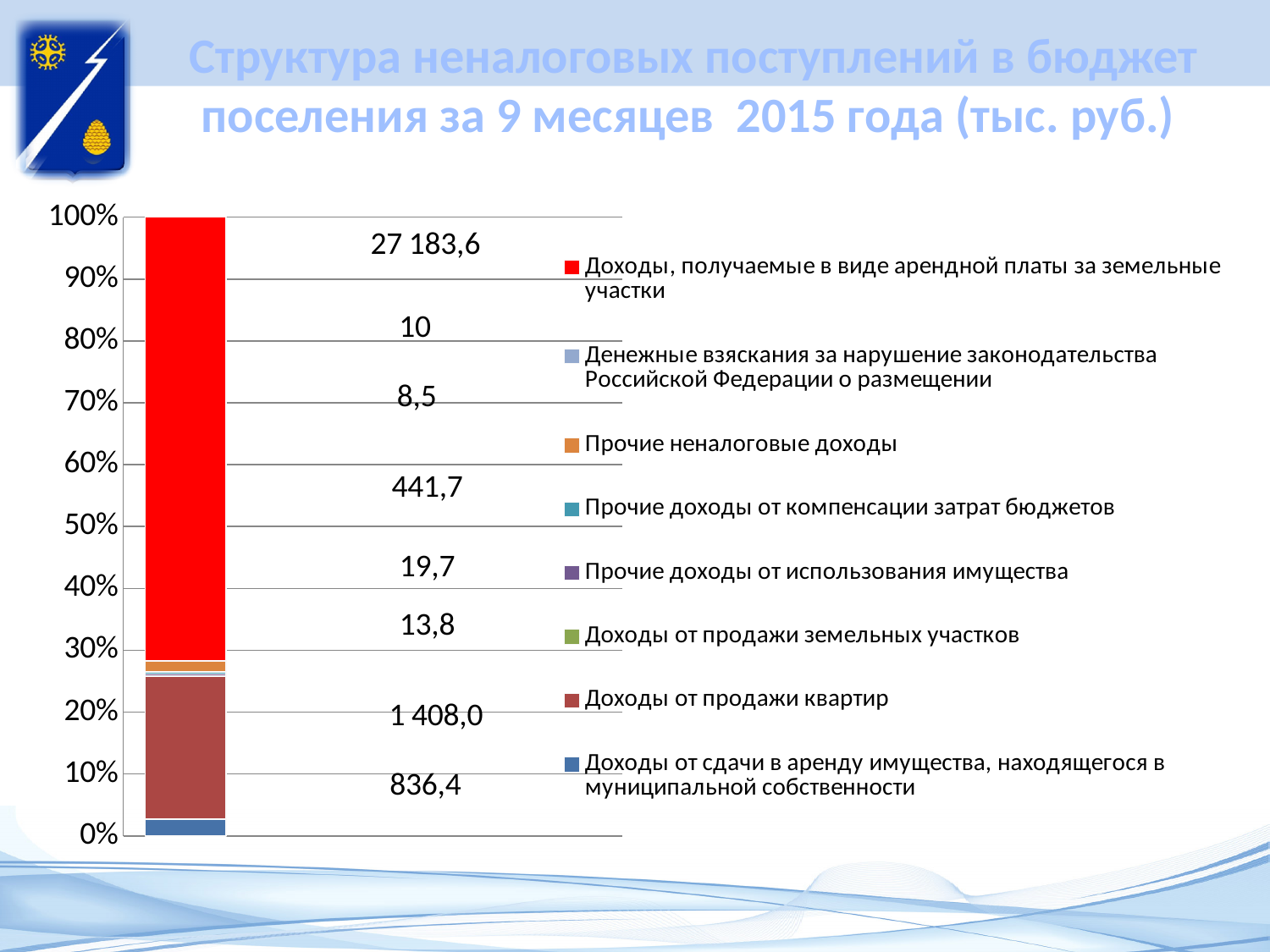
What is the difference between the values for 'Доходы от продажи квартир' and 'Доходы от сдачи в аренду имущества, находящегося в муниципальной собственности'? 571,6 How many series does the legend list? 8 Which category has the highest value? Доходы, получаемые в виде арендной платы за земельные участки What is the title of the slide? Структура неналоговых поступлений в бюджет поселения за 9 месяцев 2015 года (тыс. руб.) What value is shown for 'Прочие доходы от компенсации затрат бюджетов'? 441,7 Which is larger: the value for 'Прочие доходы от компенсации затрат бюджетов' or for 'Прочие доходы от использования имущества'? Прочие доходы от компенсации затрат бюджетов How many bars are plotted in the chart? 1 What value is shown for 'Доходы от продажи квартир'? 1 408,0 What value is shown for 'Доходы, получаемые в виде арендной платы за земельные участки'? 27 183,6 What kind of chart is shown on the slide? stacked bar chart What value is shown for 'Доходы от сдачи в аренду имущества, находящегося в муниципальной собственности'? 836,4 Which category has the lowest value? Прочие неналоговые доходы